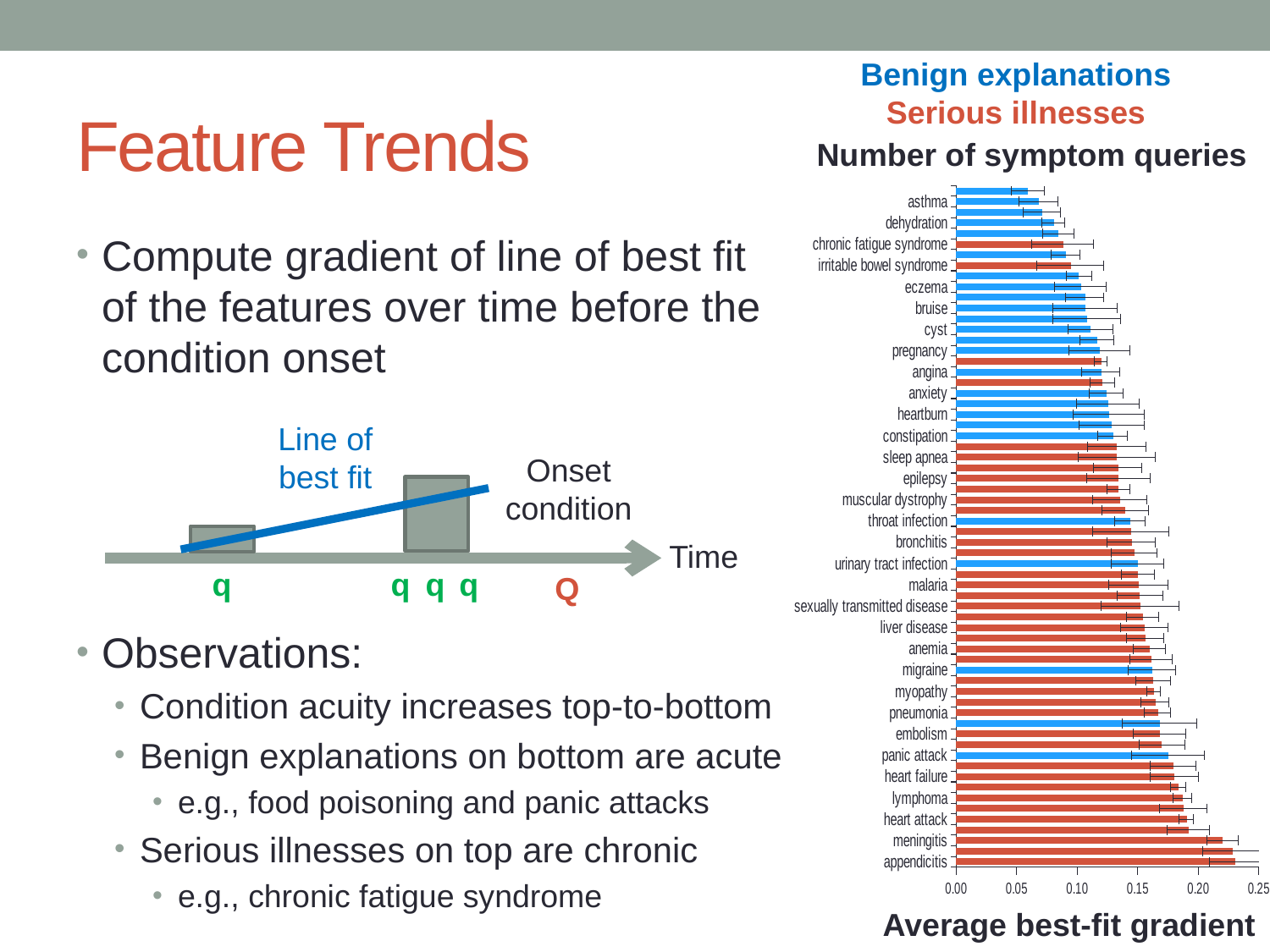
What kind of chart is shown on the right side of the slide? bar chart Is the average best-fit gradient for asthma greater or less than 0.10? less Which colour represents serious illnesses in the bar chart? red Is the average best-fit gradient for heart attack greater or less than 0.15? greater Do the average best-fit gradients generally increase or decrease going from the top of the chart (asthma) to the bottom (appendicitis)? increase Is the average best-fit gradient for pregnancy greater or less than 0.10? greater What is the title of the x axis of the bar chart? Average best-fit gradient Which has a larger average best-fit gradient, appendicitis or asthma? appendicitis